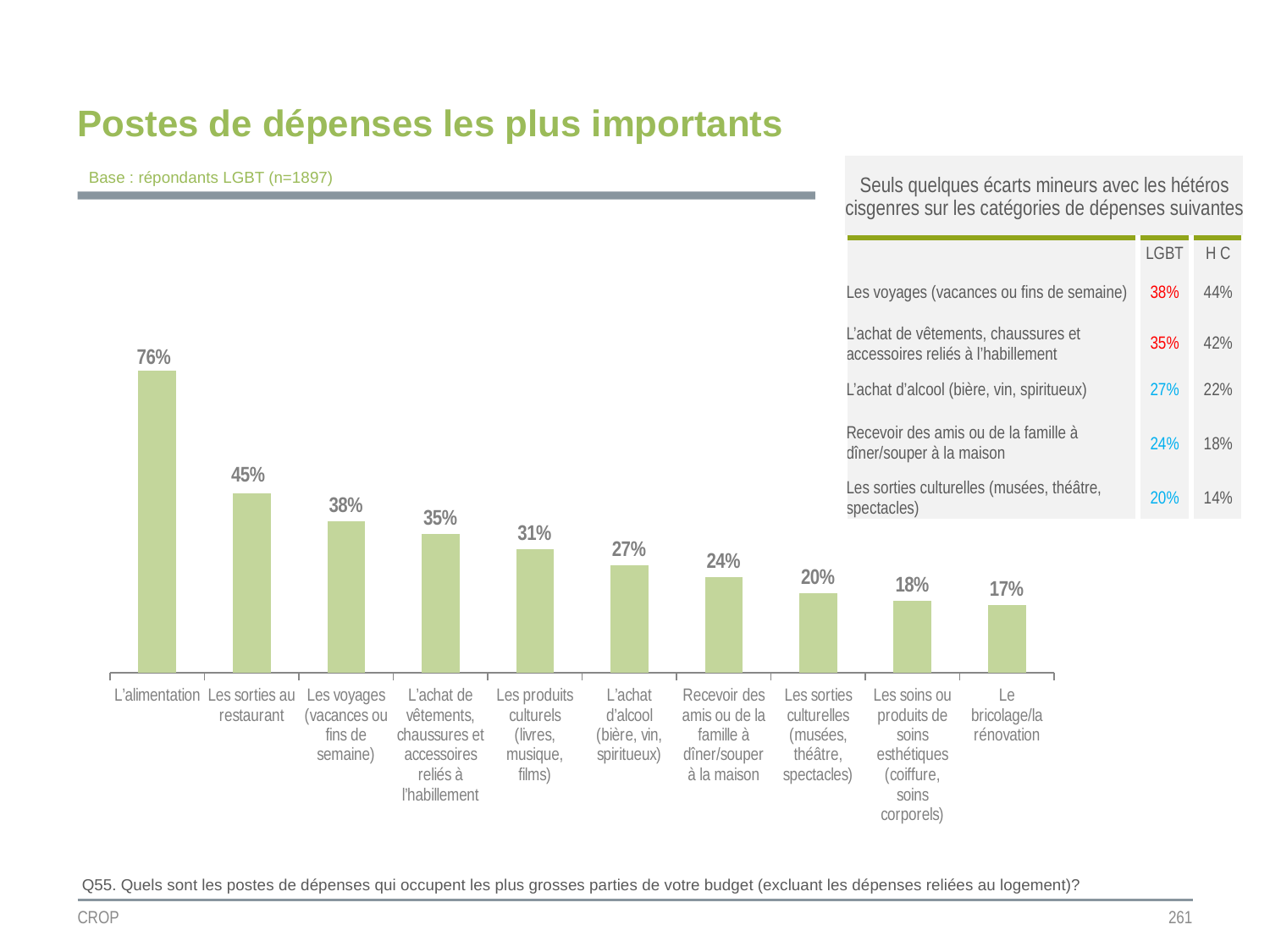
What is the value for L'alimentation? 76% Which category has the lowest value? Le bricolage/la rénovation What is the value for Le bricolage/la rénovation? 17% What is the value for Les sorties au restaurant? 45% What is the difference between L'alimentation and Les sorties au restaurant? 31 percentage points Which is larger: Les voyages (vacances ou fins de semaine) or Les produits culturels (livres, musique, films)? Les voyages (vacances ou fins de semaine) What kind of chart is shown on the slide? Bar chart Which category has the highest value? L'alimentation What is the value for L'achat d'alcool (bière, vin, spiritueux)? 27% What is the title of the slide containing the chart? Postes de dépenses les plus importants How many categories are shown in the bar chart? 10 Do the values rise or fall from left to right along the x axis? Fall